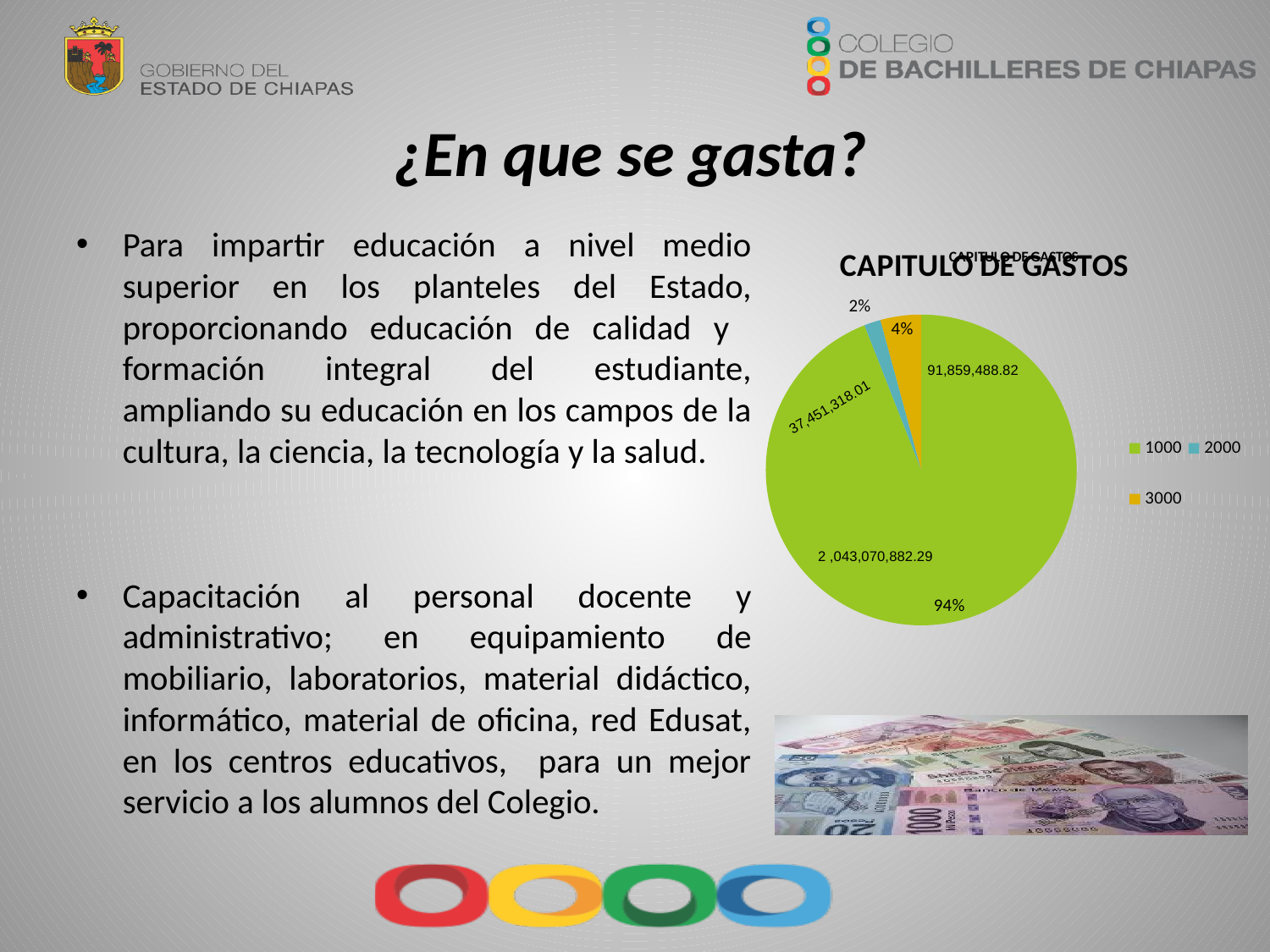
Which category has the smallest slice of the pie? 2000 How many entries does the chart legend list? 3 What is the difference between the values for category 3000 and category 2000? 54,408,170.81 What is the value shown for category 2000? 37,451,318.01 What kind of chart is shown on the slide? pie chart What share of the pie does category 3000 represent? 4% What is the title of the chart? CAPITULO DE GASTOS Which category has the largest slice of the pie? 1000 What share of the pie does category 1000 represent? 94% What is the value shown for category 3000? 91,859,488.82 What is the value shown for category 1000? 2,043,070,882.29 How many slices does the pie chart have? 3